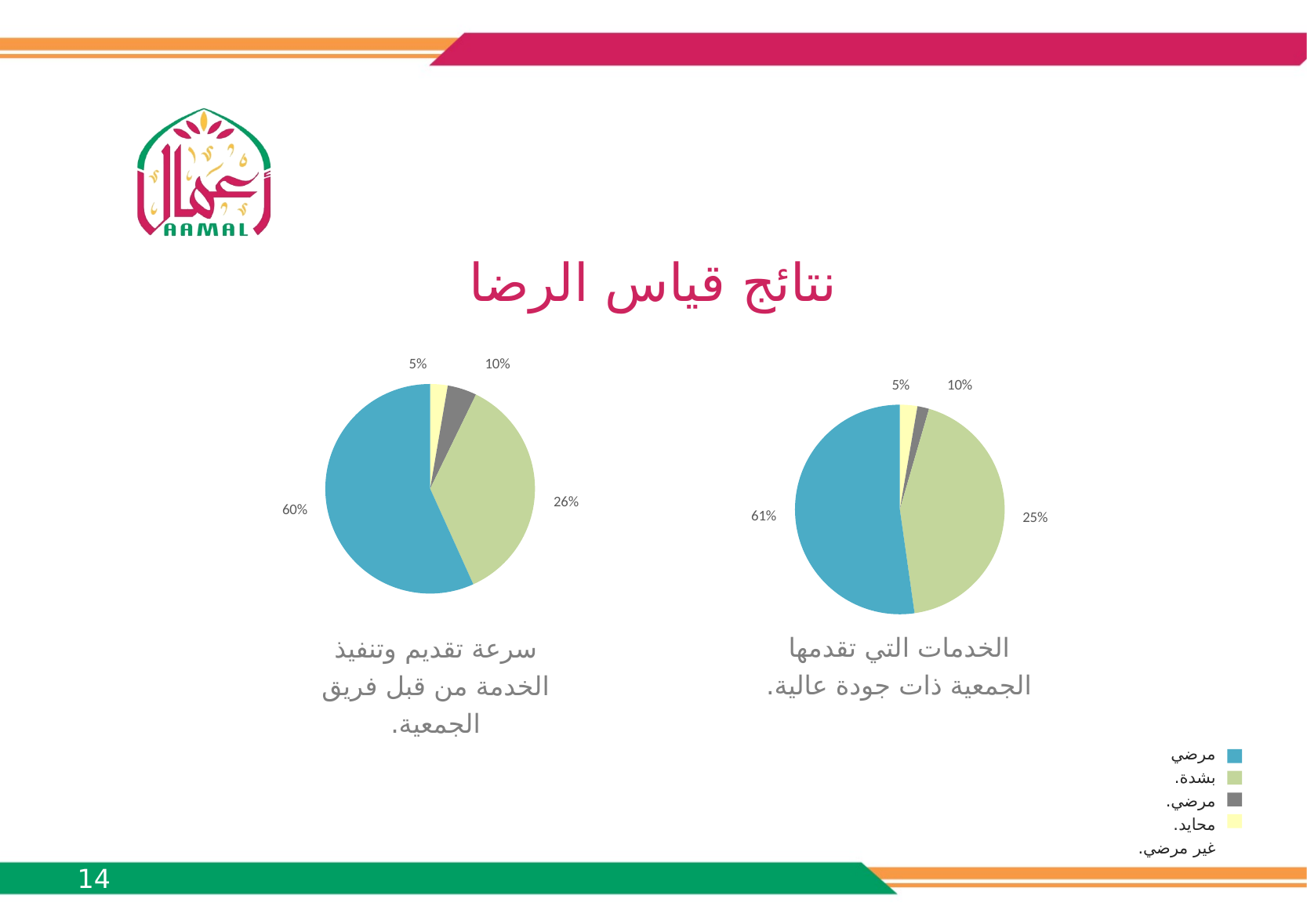
How many slices does the left chart (سرعة تقديم وتنفيذ الخدمة) have? 4 How many pie charts are shown on the slide? 2 In the right chart (الخدمات التي تقدمها الجمعية ذات جودة عالية), what percentage is shown for the green slice? 25% In the right chart (الخدمات التي تقدمها الجمعية ذات جودة عالية), what percentage is shown for the blue slice? 61% In the left chart (سرعة تقديم وتنفيذ الخدمة), which slice is the largest? The blue slice (60%) In the left chart (سرعة تقديم وتنفيذ الخدمة), what is the difference between the blue slice and the green slice? 34 percentage points In the left chart (سرعة تقديم وتنفيذ الخدمة), what percentage is shown for the green slice? 26% In the right chart (الخدمات التي تقدمها الجمعية ذات جودة عالية), what is the smallest percentage labelled? 5% Which chart has the larger blue slice, the left chart (60%) or the right chart (61%)? The right chart (61%) What kind of chart is the left chart titled 'سرعة تقديم وتنفيذ الخدمة من قبل فريق الجمعية'? Pie chart What is the title of the slide above the two pie charts? نتائج قياس الرضا In the left chart (سرعة تقديم وتنفيذ الخدمة), what percentage is shown for the blue slice? 60%